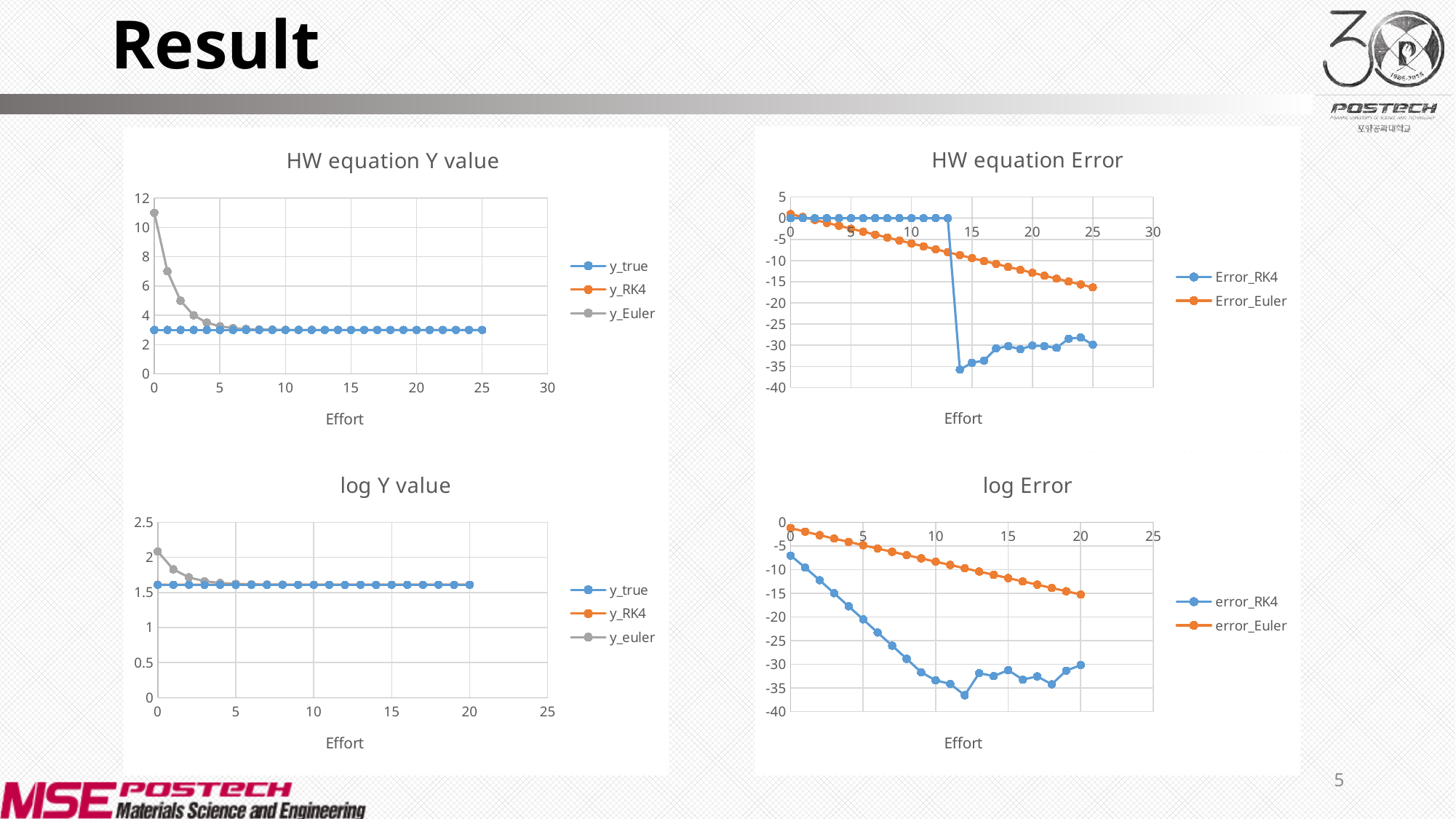
In the 'HW equation Y value' chart, does the y_Euler series rise or fall as Effort increases? fall In the 'log Y value' chart, is the y_euler value at Effort 0 greater or less than 1.5? greater What is the x-axis title of the 'log Y value' chart? Effort In the 'HW equation Y value' chart, is the y_Euler value at Effort 0 greater or less than 10? greater In the 'log Error' chart, is the error_RK4 value at Effort 0 greater or less than -10? greater In the 'HW equation Error' chart, which series has the larger value at Effort 20, Error_RK4 or Error_Euler? Error_Euler How many series does the legend of the 'HW equation Error' chart list? 2 In the 'HW equation Error' chart, does the Error_Euler series rise or fall as Effort increases? fall How many series does the legend of the 'HW equation Y value' chart list? 3 What kind of chart is the 'HW equation Y value' chart? line chart In the 'log Error' chart, which series has the larger value at Effort 10, error_RK4 or error_Euler? error_Euler